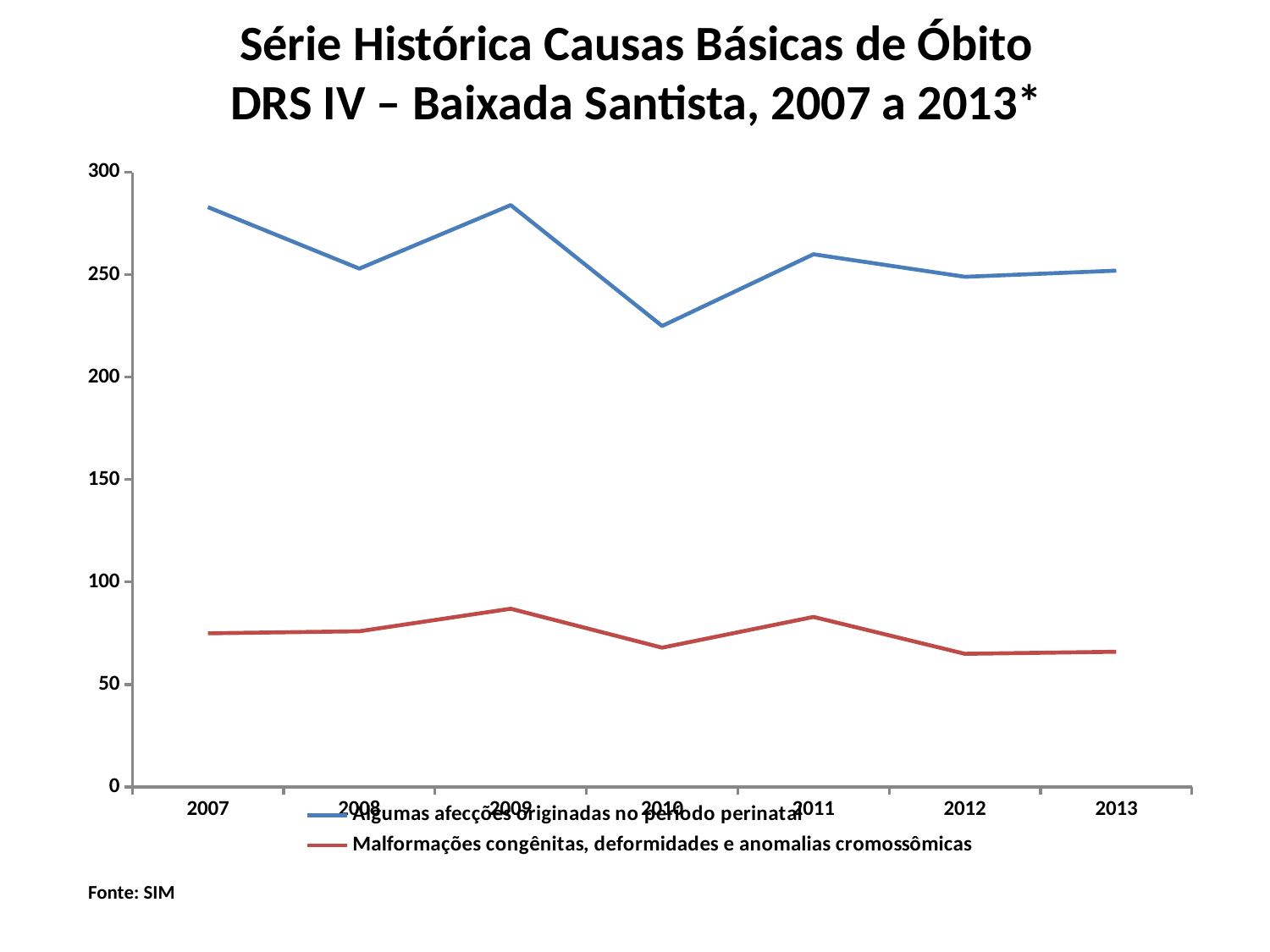
Which colour is used for the 'Malformações congênitas, deformidades e anomalias cromossômicas' line? Red Is the value for 'Malformações congênitas, deformidades e anomalias cromossômicas' in 2009 greater or less than 100? less Which year has the lowest value for 'Algumas afecções originadas no período perinatal'? 2010 Is the value for 'Malformações congênitas, deformidades e anomalias cromossômicas' in 2012 greater or less than 50? greater How many years are plotted along the x axis? 7 Does the value for 'Algumas afecções originadas no período perinatal' rise or fall from 2009 to 2010? Fall What kind of chart is shown on the slide? Line chart How many series does the legend list? 2 Is the value for 'Algumas afecções originadas no período perinatal' in 2009 greater or less than 250? greater Which year has the highest value for 'Malformações congênitas, deformidades e anomalias cromossômicas'? 2009 For 'Algumas afecções originadas no período perinatal', which year has the larger value, 2008 or 2010? 2008